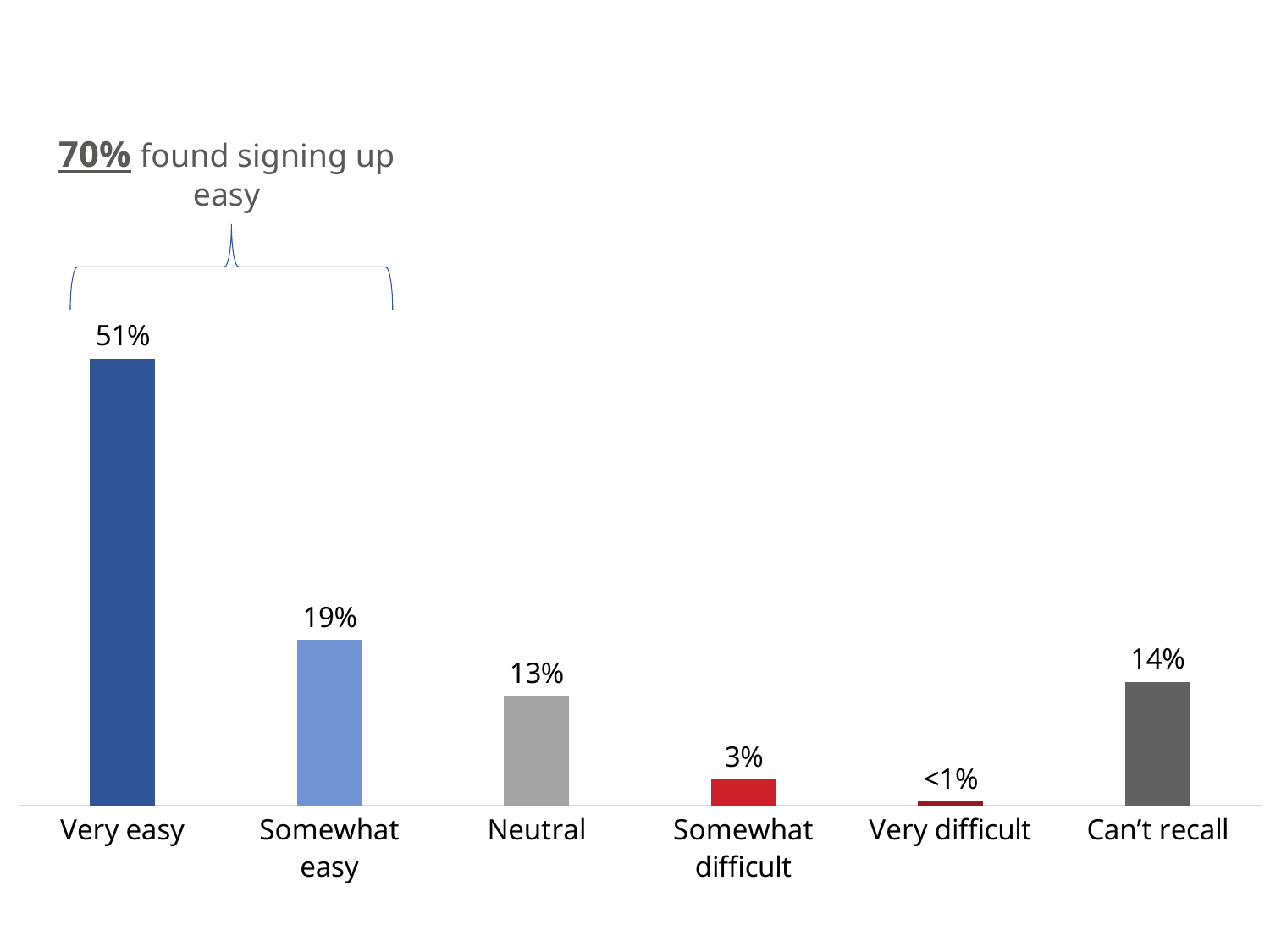
What is the value for Somewhat easy? 19% What is the value shown for Very difficult? <1% Which category has the highest value? Very easy How many categories are shown on the x axis? 6 Which category has the lowest value? Very difficult What is the difference between the values for Very easy and Somewhat easy? 32% What is the value for Very easy? 51% What kind of chart is shown on the slide? Bar chart Which is larger, the value for Neutral or the value for Can't recall? Can't recall What is the value for Can't recall? 14% What is the value for Somewhat difficult? 3% What is the value for Neutral? 13%